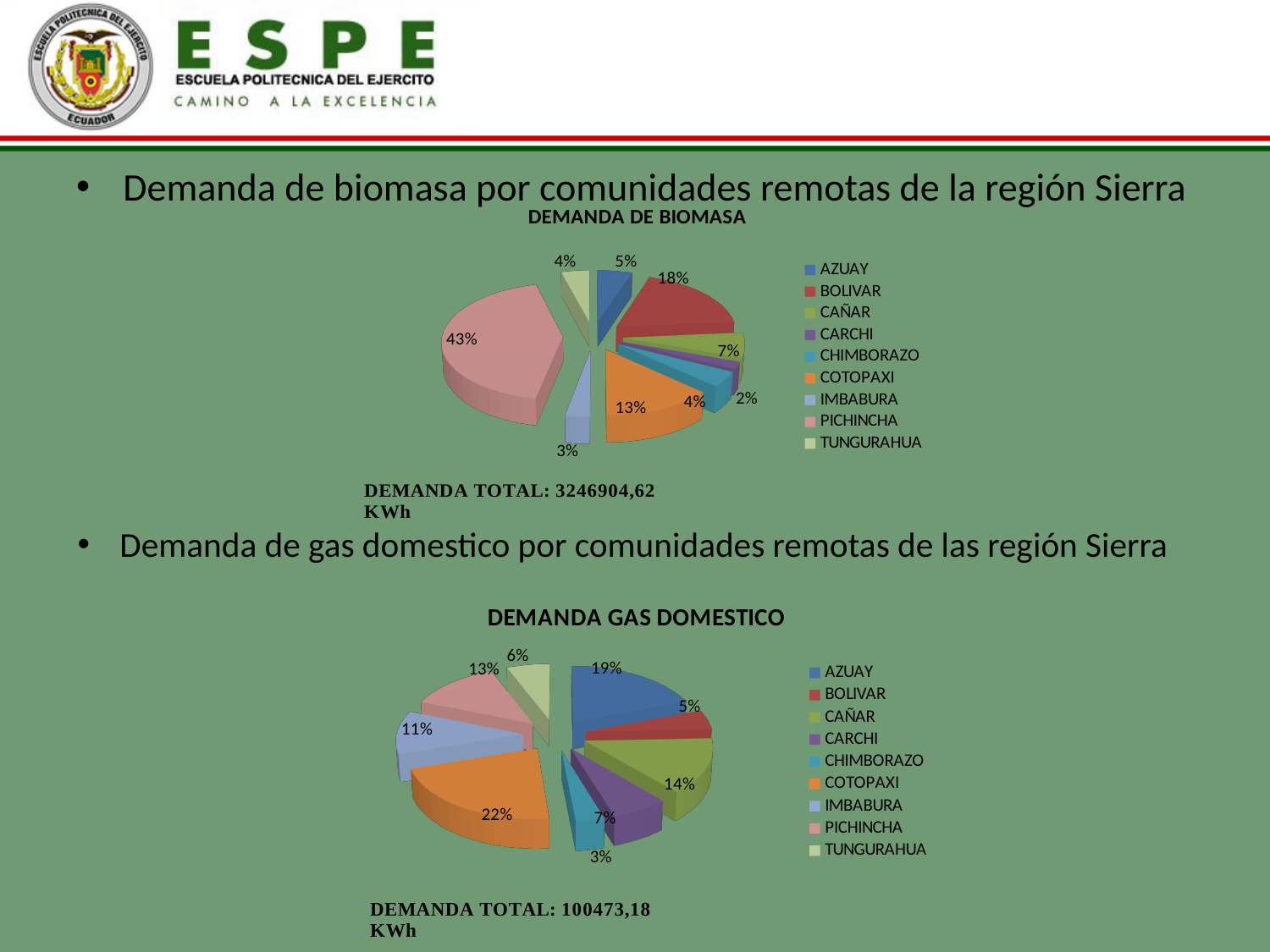
In the DEMANDA DE BIOMASA chart, what is the difference between the PICHINCHA and COTOPAXI shares? 30% In the DEMANDA DE BIOMASA chart, what share does BOLIVAR have? 18% In the DEMANDA DE BIOMASA chart, which province has the largest slice? PICHINCHA In the DEMANDA GAS DOMESTICO chart, what share does AZUAY have? 19% In the DEMANDA GAS DOMESTICO chart, which is larger, the share for CAÑAR or the share for IMBABURA? CAÑAR In the DEMANDA GAS DOMESTICO chart, which province has the smallest slice? CHIMBORAZO In the DEMANDA DE BIOMASA chart, what share does PICHINCHA have? 43% What total demand is stated below the DEMANDA GAS DOMESTICO chart? 100473,18 KWh In the DEMANDA DE BIOMASA chart, which province has the smallest slice? CARCHI How many provinces are listed in the legend of the DEMANDA DE BIOMASA chart? 9 What type of chart is the DEMANDA GAS DOMESTICO chart? Pie chart